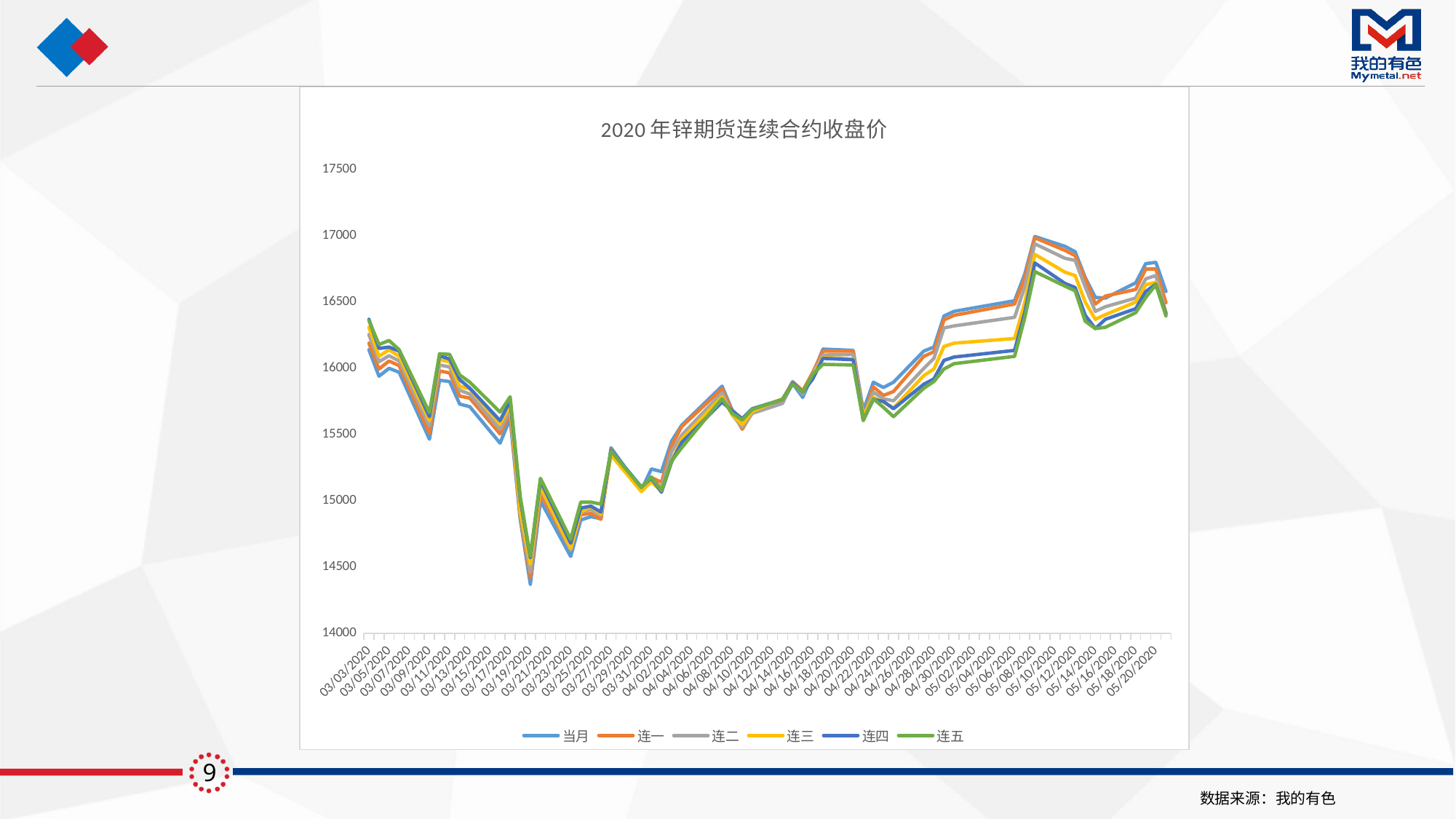
Is the value of 连五 at 03/03/2020 greater or less than 16500? less How many series does the legend list? 6 Do the series values rise or fall between 03/03/2020 and 03/19/2020? fall Is the value of 当月 at 03/03/2020 greater or less than 16000? greater Is the lowest value reached by the 当月 series greater or less than 14500? less What is the highest value shown on the vertical axis? 17500 What is the title of the chart? 2020 年锌期货连续合约收盘价 Which series is drawn in green in the legend? 连五 Around 05/06/2020, which series is higher, 当月 or 连五? 当月 What kind of chart is shown on the slide? line chart Do the series values rise or fall between 03/25/2020 and 05/08/2020? rise